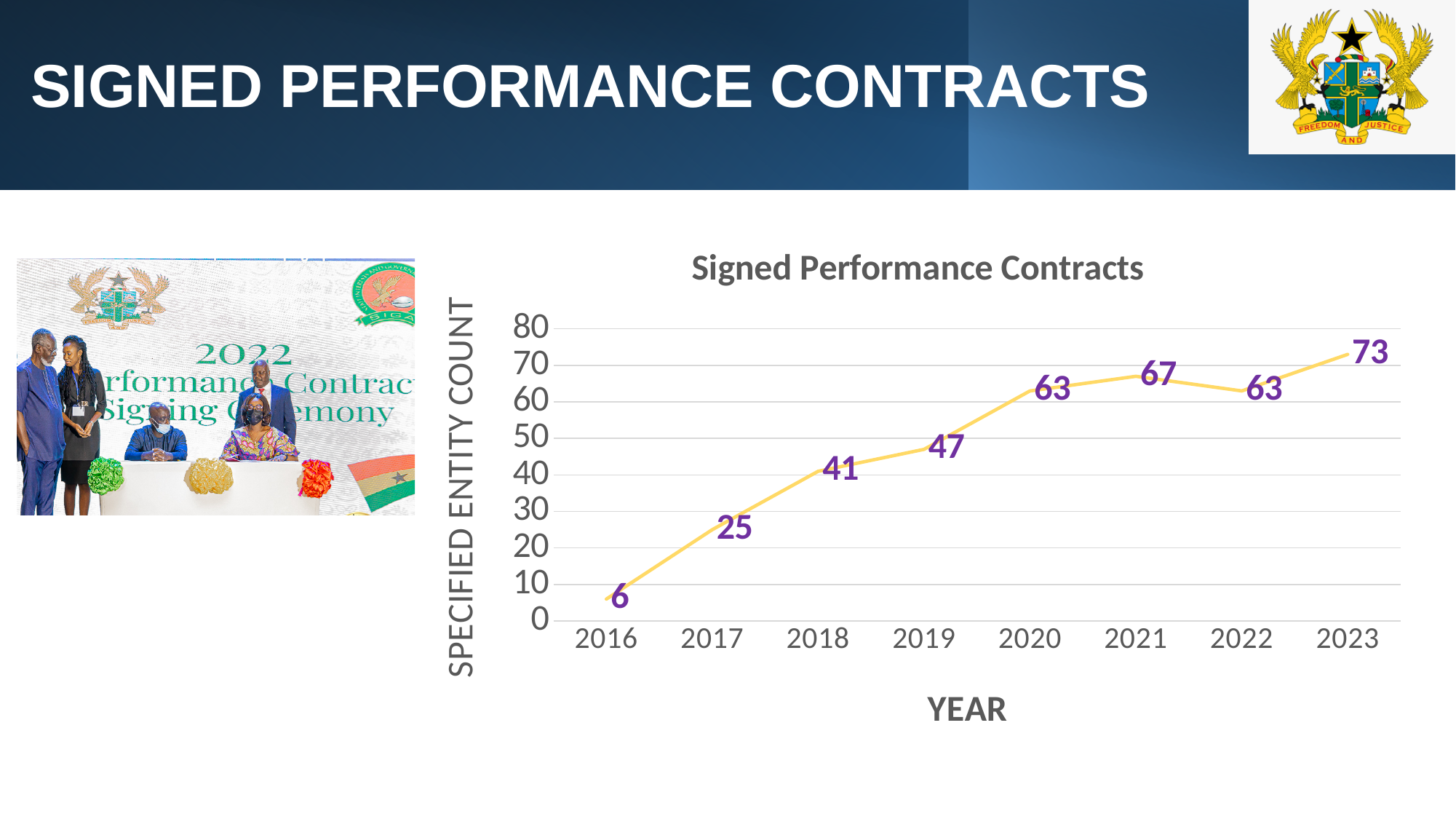
What is the value for 2022 in the Signed Performance Contracts chart? 63 What is the difference between the values for 2023 and 2016 in the Signed Performance Contracts chart? 67 Which is larger in the Signed Performance Contracts chart, the value for 2018 or the value for 2017? 2018 How many years are plotted in the Signed Performance Contracts chart? 8 Which year has the lowest value in the Signed Performance Contracts chart? 2016 What is the value for 2016 in the Signed Performance Contracts chart? 6 Do the values in the Signed Performance Contracts chart generally rise or fall from 2016 to 2023? rise What kind of chart is the Signed Performance Contracts chart? line chart Which year has the highest value in the Signed Performance Contracts chart? 2023 What is the value for 2019 in the Signed Performance Contracts chart? 47 What is the difference between the values for 2021 and 2022 in the Signed Performance Contracts chart? 4 What is the label of the vertical axis in the Signed Performance Contracts chart? SPECIFIED ENTITY COUNT